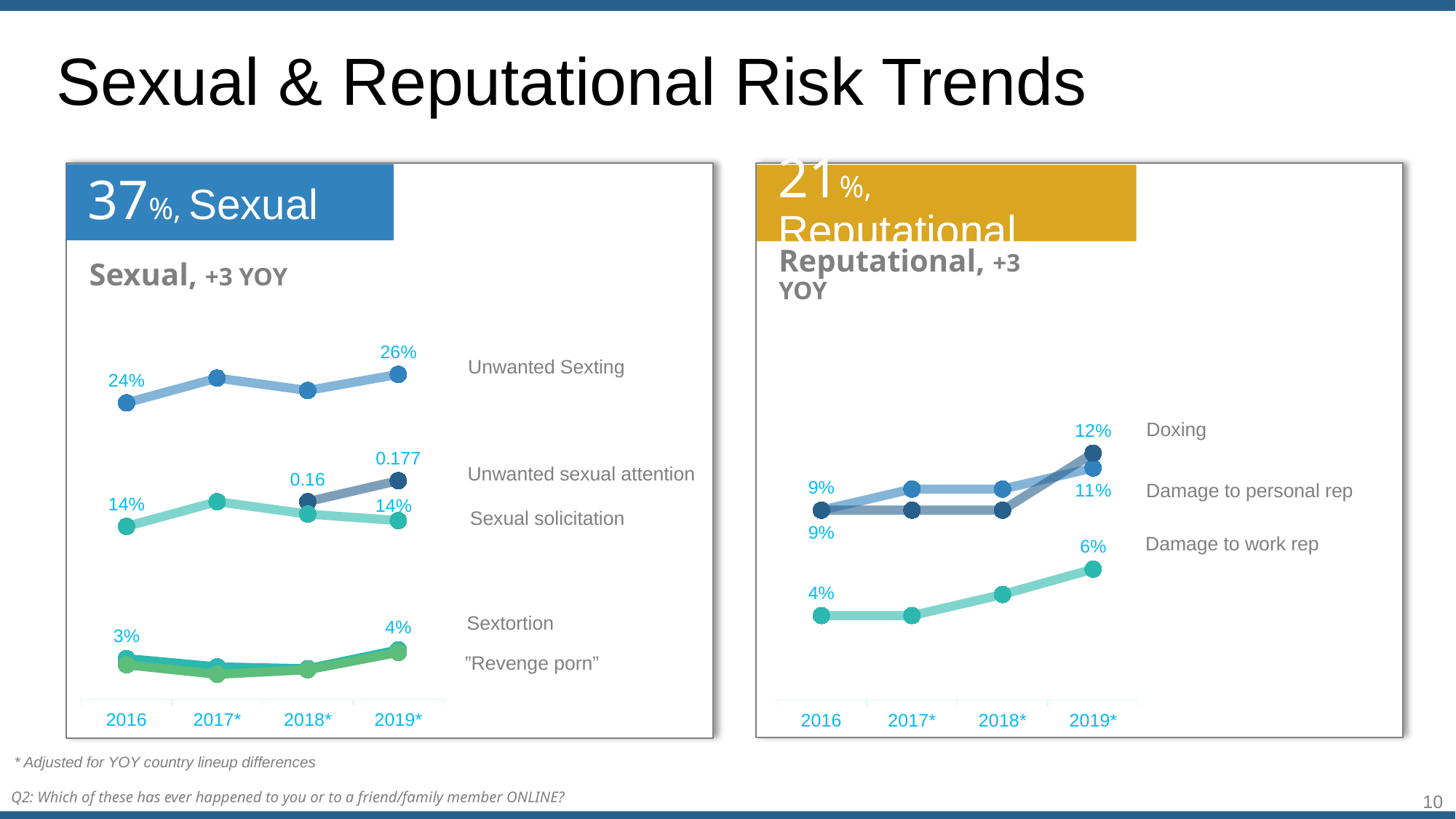
How many years are shown on the x axis of the Sexual chart? 4 In the Reputational chart, what is the value for Damage to work rep in 2016? 4% In the Sexual chart, what is the value for Sextortion in 2019*? 4% In the Sexual chart, what is the value for Unwanted Sexting in 2019*? 26% In the Reputational chart, what is the value for Doxing in 2019*? 12% In the Reputational chart, what is the difference between Damage to work rep in 2019* and in 2016? 2 percentage points In the Sexual chart, what is the value for Unwanted sexual attention in 2019*? 0.177 In the Sexual chart, what is the value for Unwanted Sexting in 2016? 24% In the Reputational chart, which is higher in 2019*: Doxing or Damage to personal rep? Doxing In the Reputational chart, does Damage to work rep rise or fall from 2016 to 2019*? Rise In the Sexual chart, by how many percentage points did Unwanted Sexting change from 2016 to 2019*? 2 percentage points What type of chart is the Reputational chart? Line chart